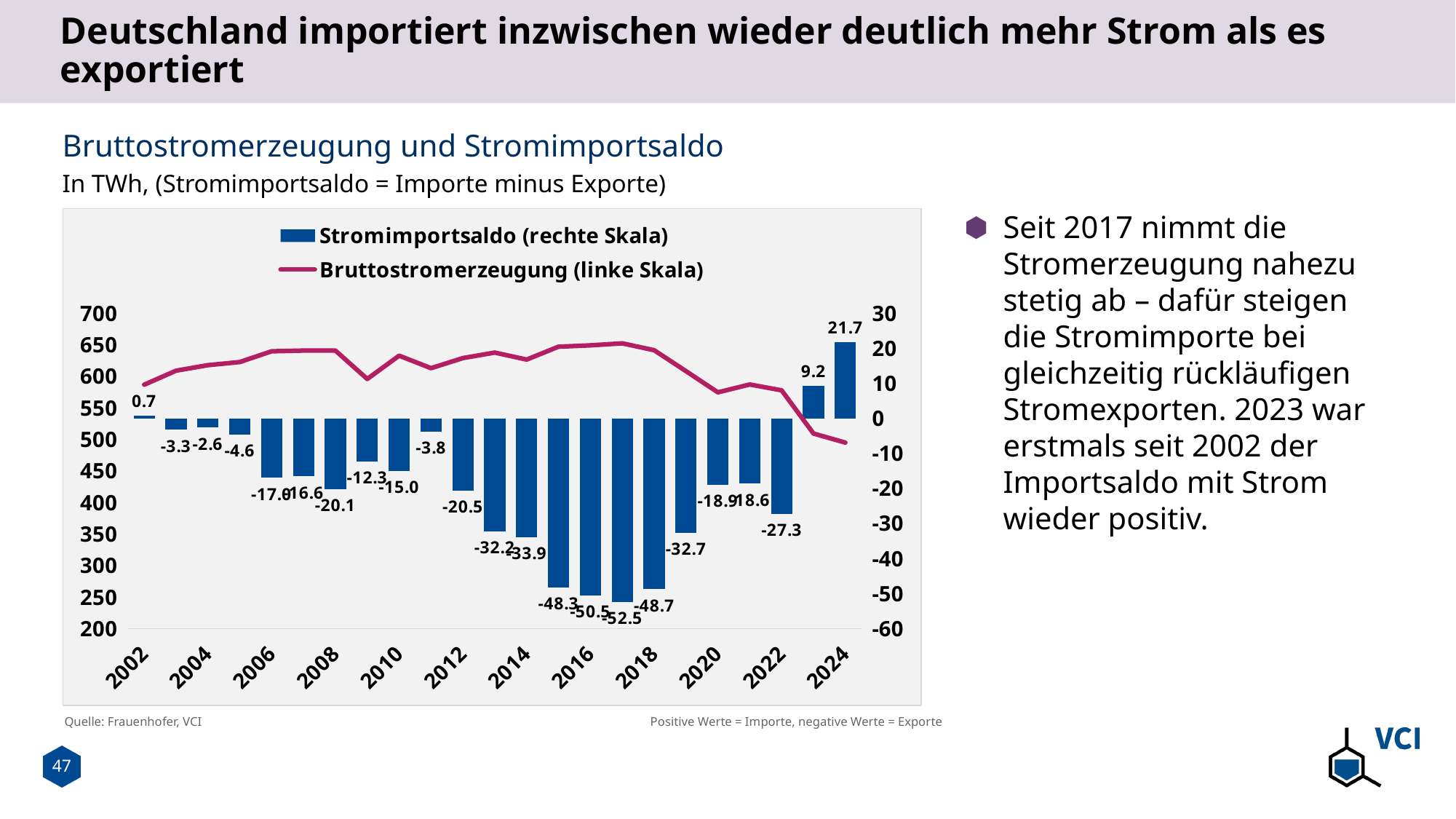
By how much did the Stromimportsaldo increase from 2023 to 2024? 12.5 What is the Stromimportsaldo value for 2002? 0.7 How many series does the legend list? 2 In which year is the Stromimportsaldo lowest? 2017 Is the Bruttostromerzeugung value for 2002 greater or less than 550? greater What is the Stromimportsaldo value for 2024? 21.7 Which year has the larger Stromimportsaldo, 2006 or 2010? 2010 Is the Bruttostromerzeugung value for 2024 greater or less than 550? less In which year is the Stromimportsaldo highest? 2024 What is the Stromimportsaldo value for 2017? -52.5 What kind of chart is shown on the slide? Combination bar and line chart Does the Bruttostromerzeugung line rise or fall from 2017 to 2024? Fall